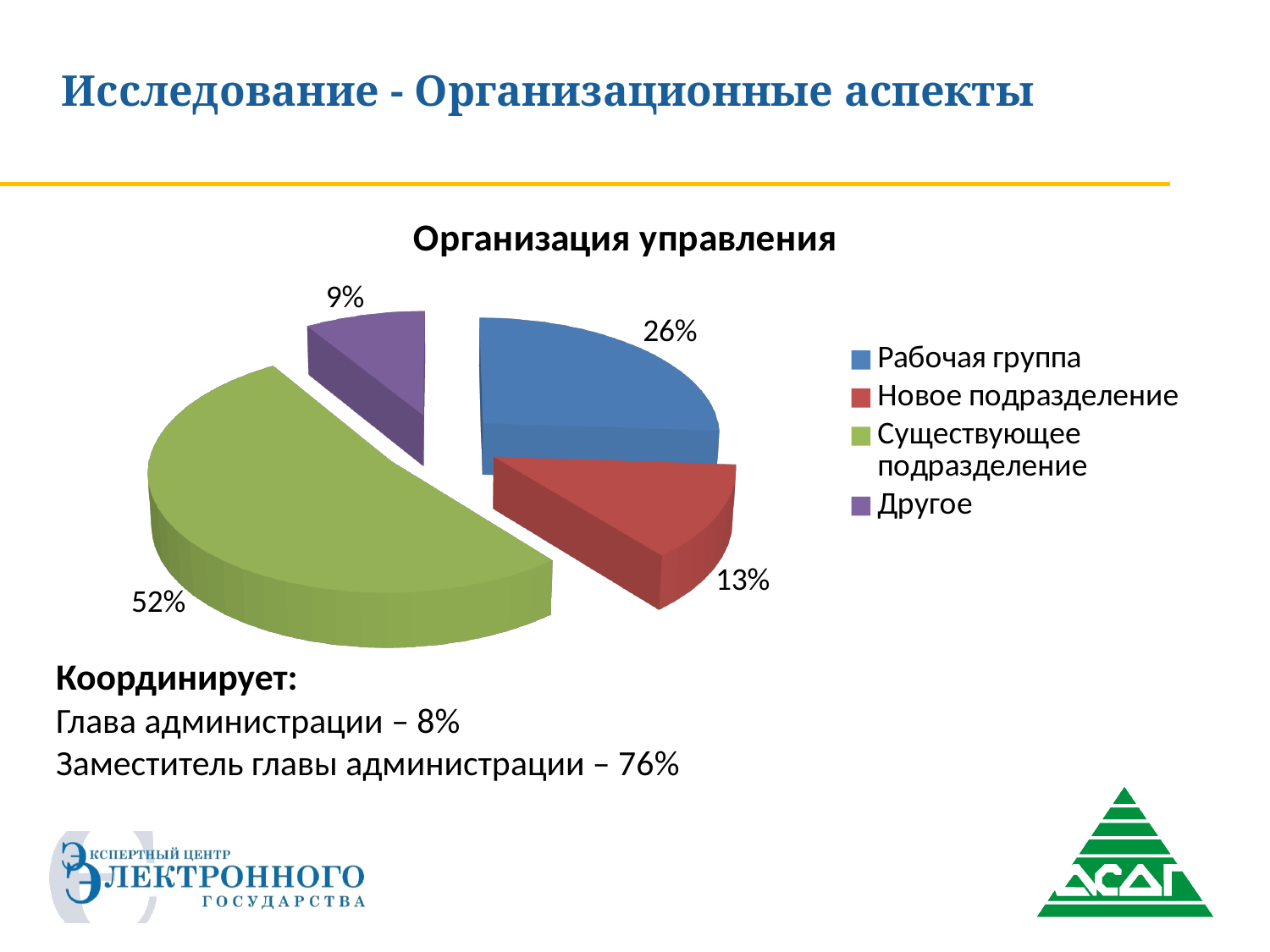
What colour is the slice for "Существующее подразделение"? Green Which is larger: the share for "Рабочая группа" or the share for "Новое подразделение"? Рабочая группа What is the title of the chart? Организация управления Which category has the smallest slice of the pie? Другое What share of the pie does "Новое подразделение" have? 13% What share of the pie does "Рабочая группа" have? 26% What share of the pie does "Существующее подразделение" have? 52% How many categories does the pie chart show? 4 Which category has the largest slice of the pie? Существующее подразделение What is the difference between the shares of "Существующее подразделение" and "Рабочая группа"? 26% What type of chart is shown on the slide? Pie chart What share of the pie does "Другое" have? 9%